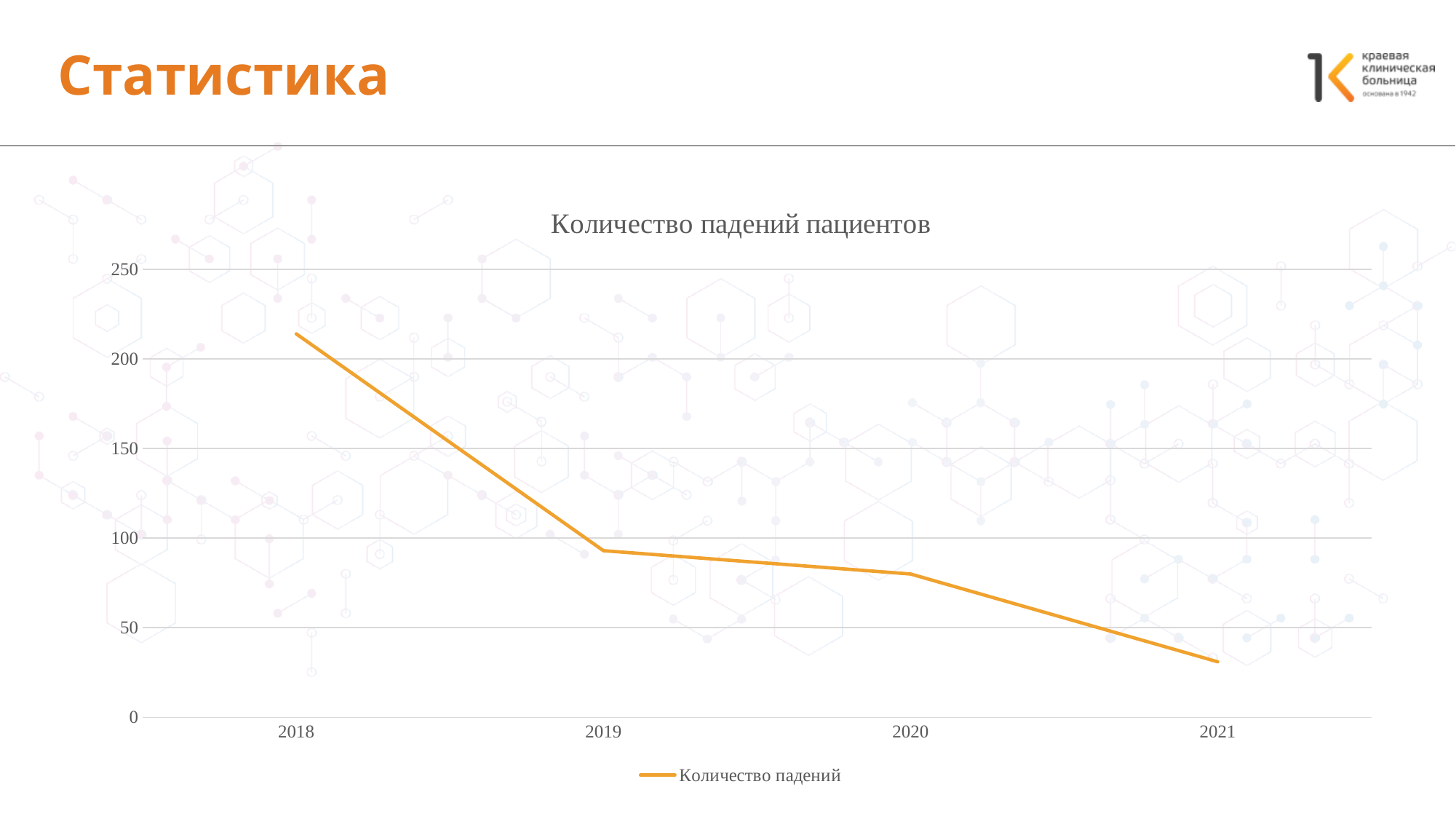
What is the title of the chart? Количество падений пациентов Which year has the highest number of patient falls? 2018 How many years are plotted along the x axis? 4 Which year has the larger value, 2019 or 2020? 2019 Is the value for 2021 greater or less than 50? less Do the values rise or fall from 2018 to 2021? fall How many series does the legend list? 1 Is the value for 2020 greater or less than 100? less What is the legend entry for the plotted line? Количество падений Is the value for 2018 greater or less than 200? greater What kind of chart is shown on the slide? line chart Which year has the lowest number of patient falls? 2021